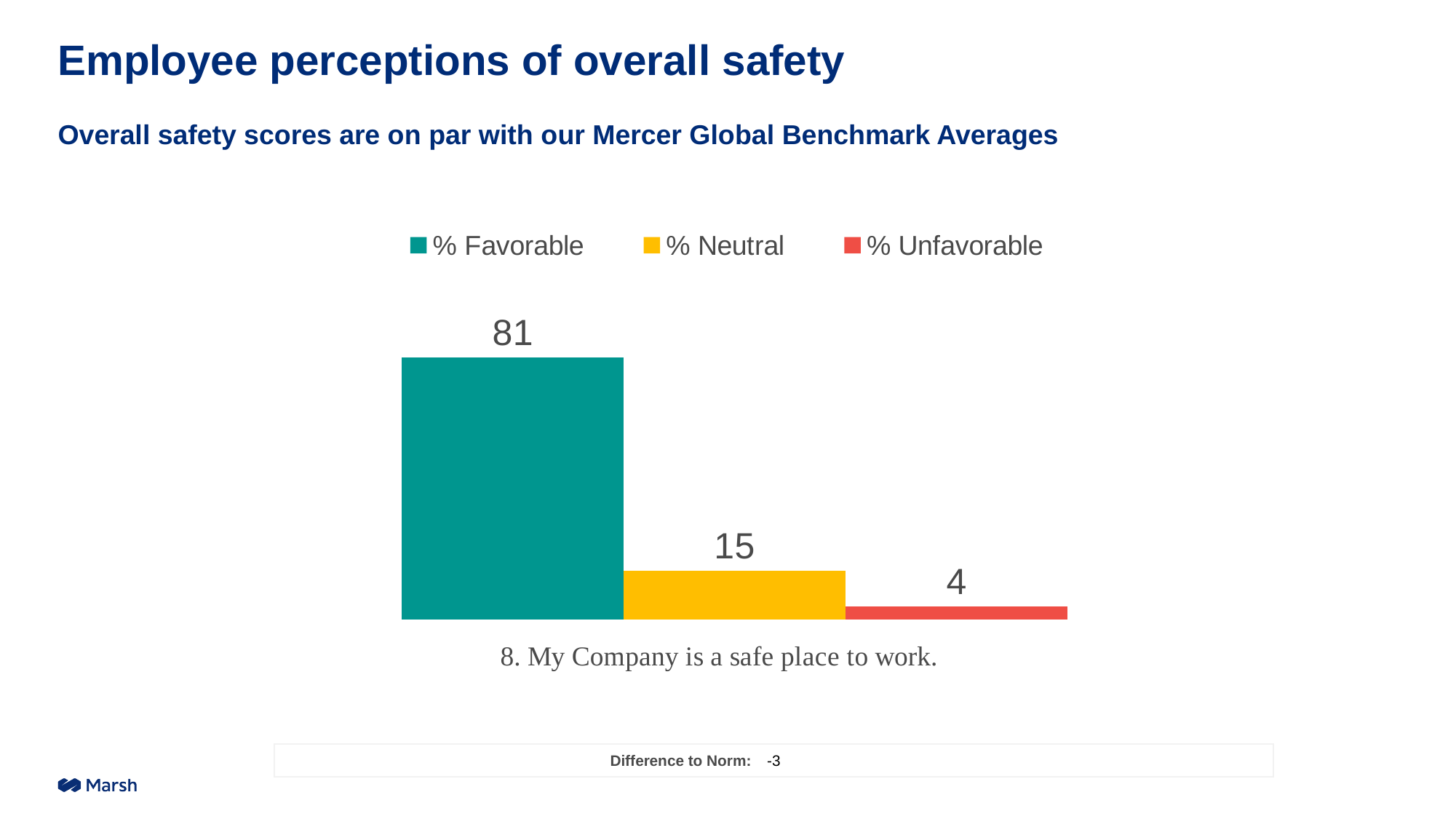
Which series has the lowest value in the chart? % Unfavorable Which is larger, the % Neutral value or the % Unfavorable value? % Neutral What is the % Unfavorable value for "8. My Company is a safe place to work."? 4 What is the % Favorable value for "8. My Company is a safe place to work."? 81 Which series has the highest value in the chart? % Favorable What is the difference between the % Neutral and % Unfavorable values? 11 What is the difference between the % Favorable and % Neutral values? 66 How many series does the legend list? 3 What is the % Neutral value for "8. My Company is a safe place to work."? 15 What is the total of the three values shown in the chart? 100 What colour is the % Favorable bar? Teal What kind of chart is shown on the slide? Bar chart